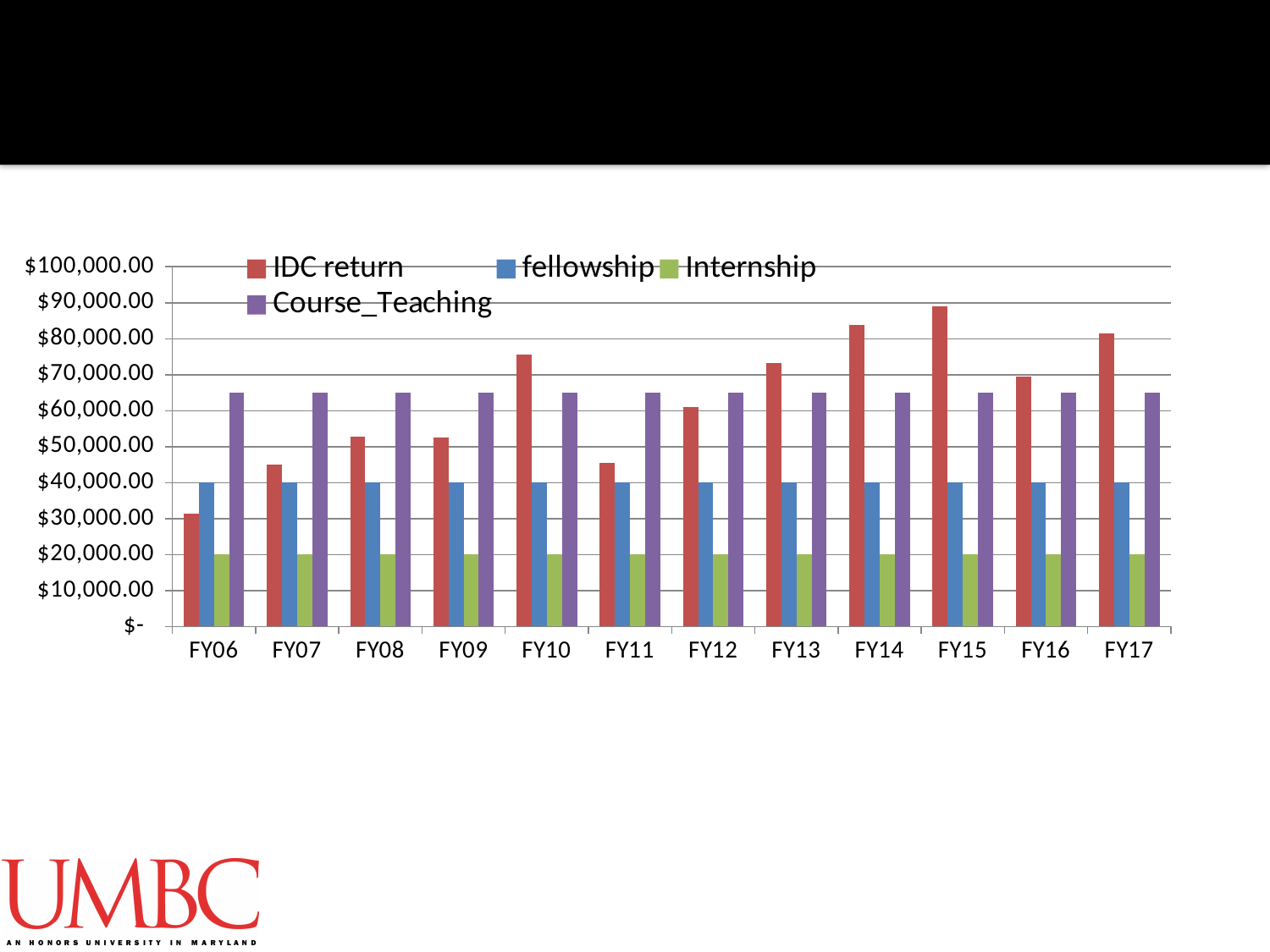
Is the IDC return for FY06 greater or less than $40,000.00? less Which is larger, the IDC return for FY15 or for FY17? FY15 Is the Course_Teaching value for FY12 greater or less than $60,000.00? greater Is the IDC return for FY14 greater or less than $80,000.00? greater In which fiscal year is the IDC return lowest? FY06 In which fiscal year is the IDC return highest? FY15 What is the fellowship value for FY10? $40,000.00 What kind of chart is shown on the slide? bar chart Which series is shown in purple in the legend? Course_Teaching What is the Internship value for FY17? $20,000.00 How many fiscal years are shown on the x axis? 12 How many series does the legend list? 4